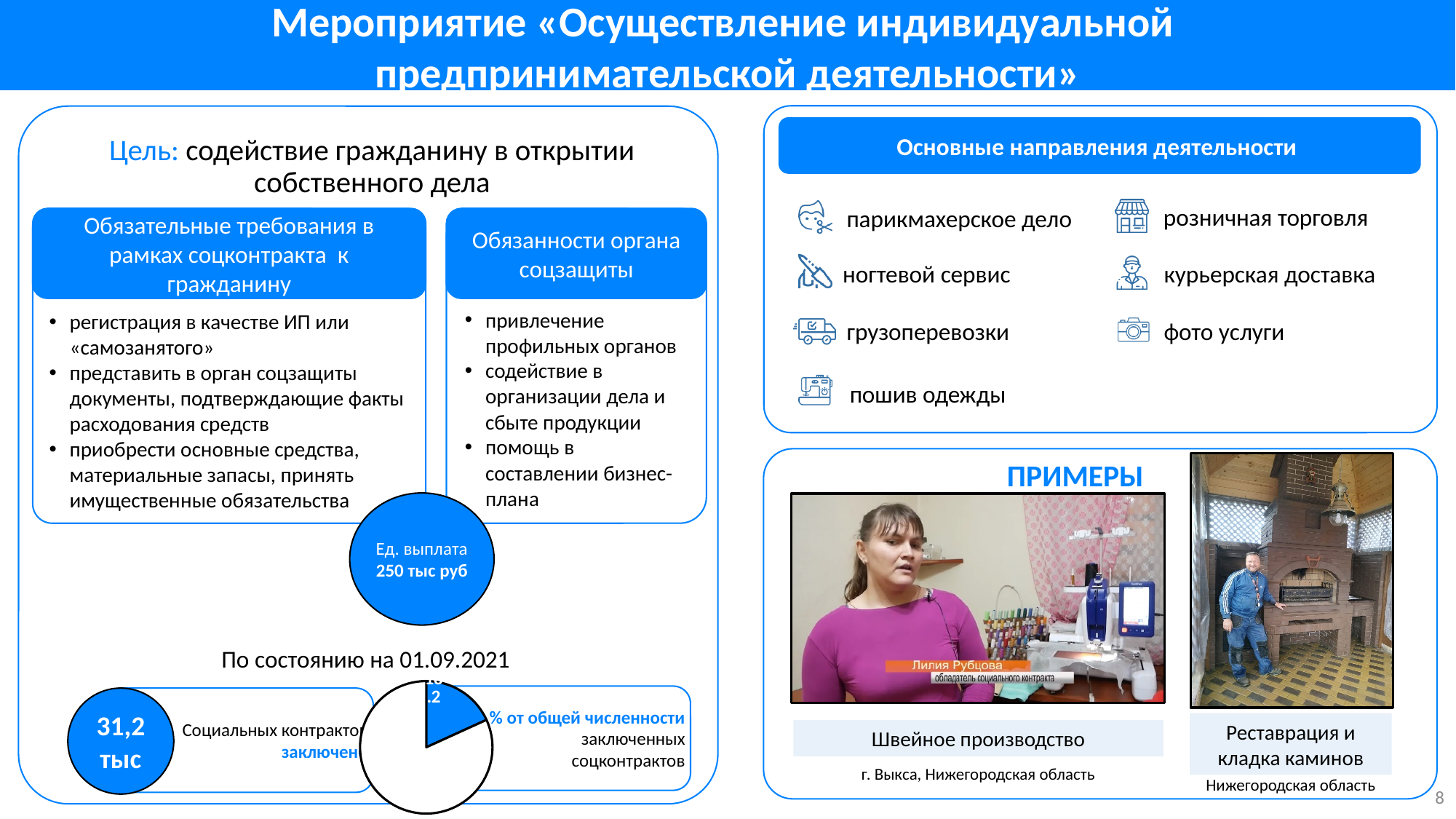
In the pie chart at the bottom left of the slide, which slice is larger, the blue one or the white one? the white one How many slices does the pie chart at the bottom left of the slide have? 2 In the pie chart at the bottom left of the slide, does the blue slice take up more or less than half of the pie? less What colour is the smaller slice of the pie chart at the bottom left of the slide? blue What kind of chart is shown at the bottom left of the slide, overlapping the text 'По состоянию на 01.09.2021'? pie chart